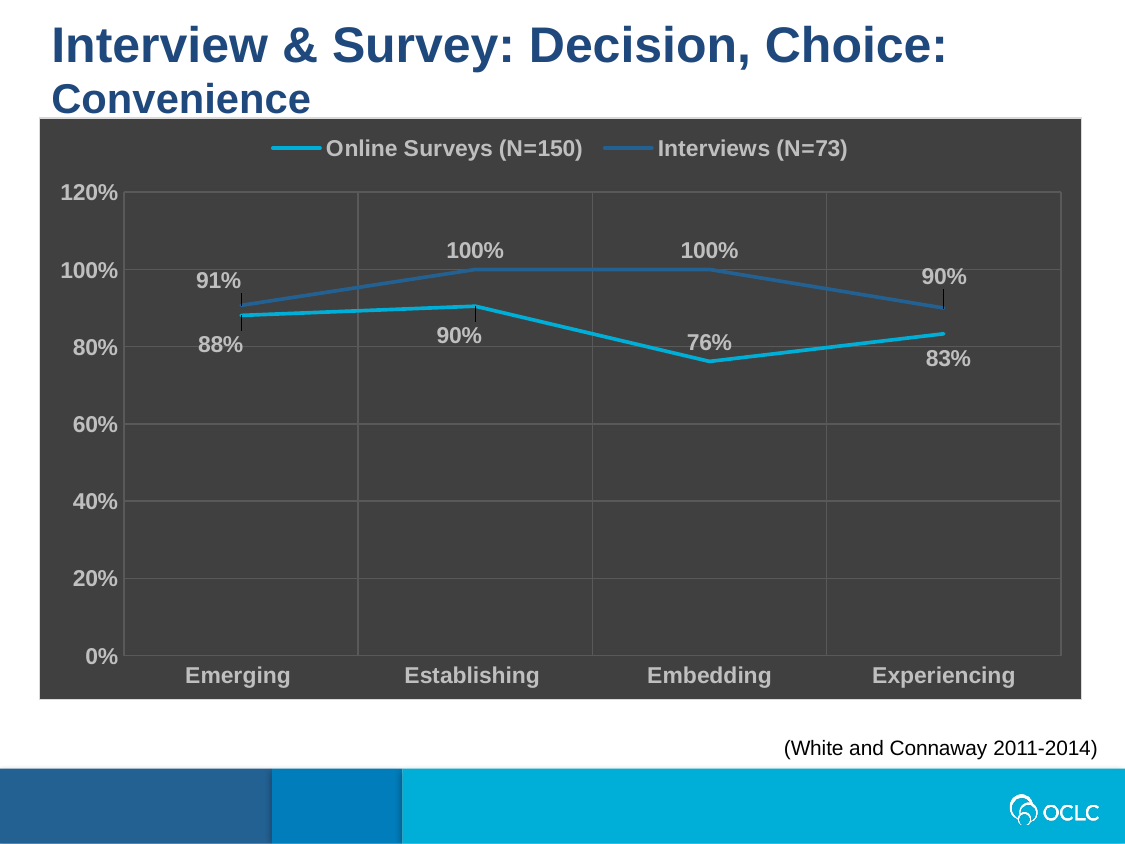
What kind of chart is shown on the slide? Line chart Does the Online Surveys line rise or fall from Establishing to Embedding? Fall What is the value for Online Surveys at Embedding? 76% What is the value for Interviews at Emerging? 91% What is the value for Online Surveys at Experiencing? 83% How many series does the legend list? 2 What sample size is given for Interviews in the legend? N=73 Which category has the lowest value for Online Surveys? Embedding Which category has the highest value for Online Surveys? Establishing What is the difference between Interviews and Online Surveys at Embedding? 24% How many categories are shown on the x axis? 4 Which is larger at Experiencing, Interviews or Online Surveys? Interviews